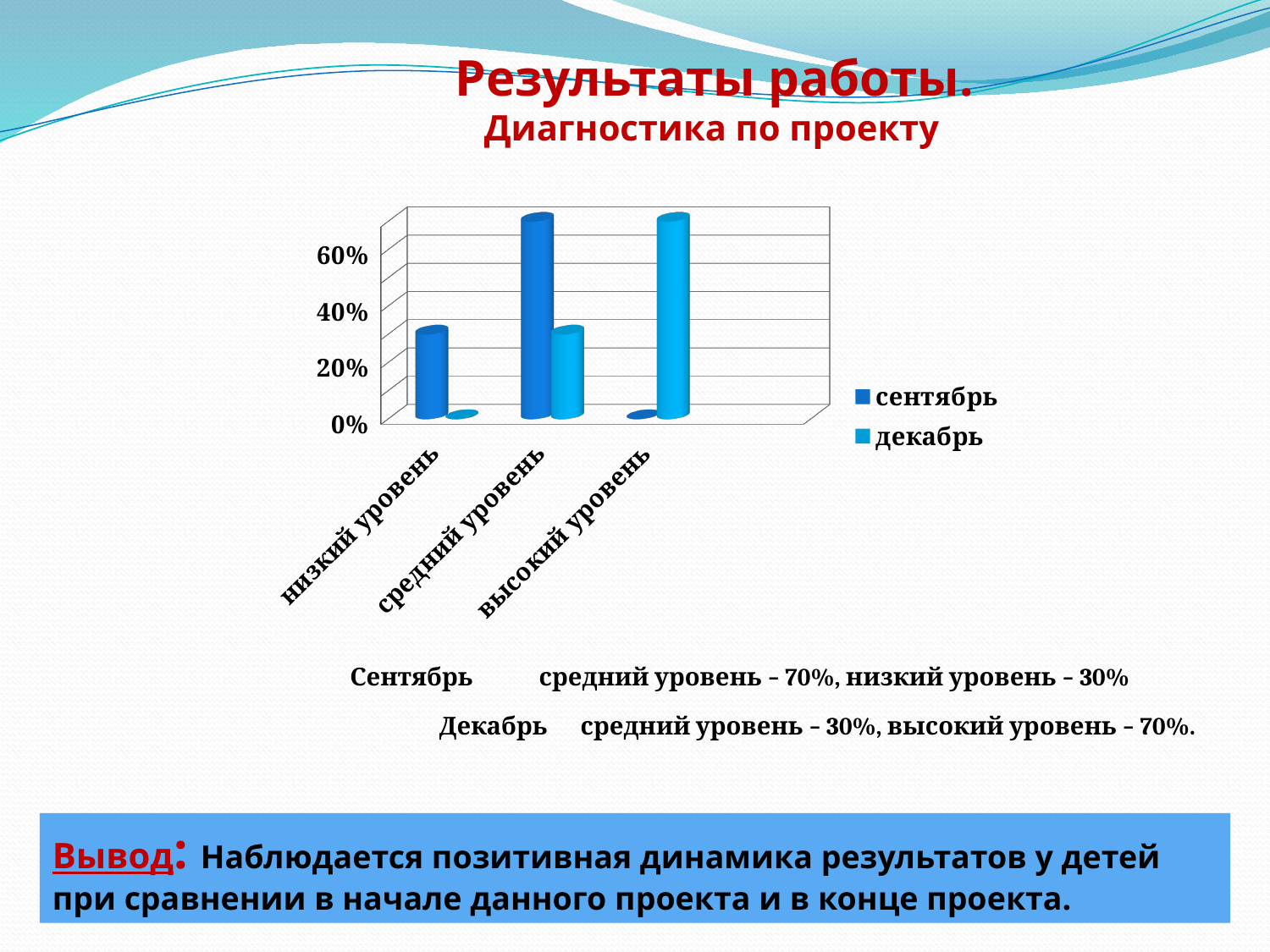
What is the difference between the сентябрь and декабрь values for средний уровень? 40% For средний уровень, which series has the larger value, сентябрь or декабрь? сентябрь What kind of chart is shown on the slide? bar chart What is the value for средний уровень in the декабрь series? 30% What is the value for средний уровень in the сентябрь series? 70% Is the value for средний уровень in the сентябрь series greater or less than 60%? greater What is the value for высокий уровень in the декабрь series? 70% How many categories are shown on the x axis of the chart? 3 What is the value for низкий уровень in the сентябрь series? 30% Which category has the highest value in the декабрь series? высокий уровень Which category has the highest value in the сентябрь series? средний уровень How many series does the legend list? 2